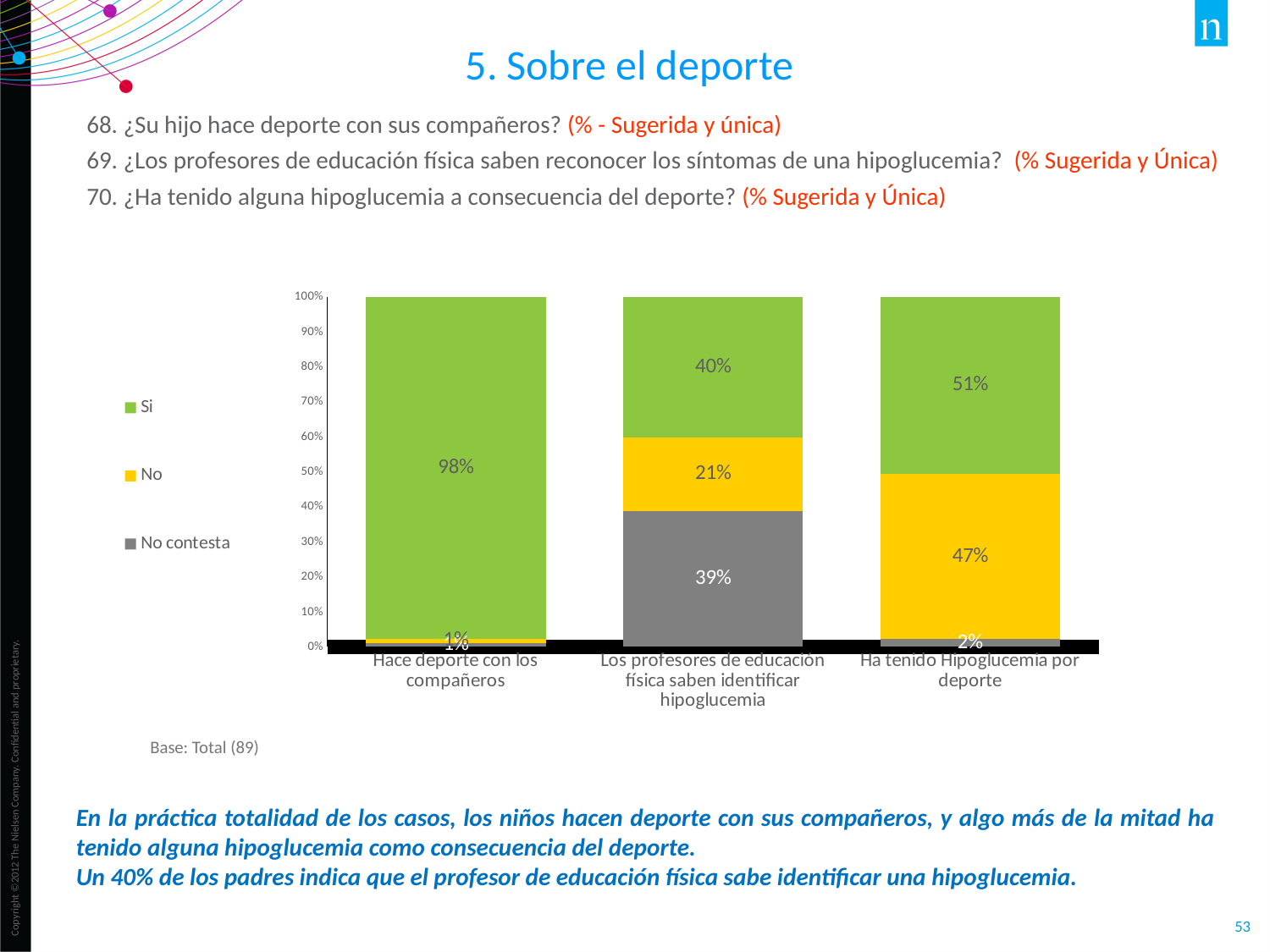
Which category has the highest 'Si' value? Hace deporte con los compañeros What is the value of 'No contesta' for 'Los profesores de educación física saben identificar hipoglucemia'? 39% How many series does the legend list? 3 Which colour represents the 'No' series in the chart? yellow What is the value of 'Si' for 'Los profesores de educación física saben identificar hipoglucemia'? 40% What is the value of 'Si' for 'Ha tenido Hipoglucemia por deporte'? 51% What is the difference between the 'Si' and 'No' values for 'Los profesores de educación física saben identificar hipoglucemia'? 19% What is the value of 'No' for 'Ha tenido Hipoglucemia por deporte'? 47% Which is larger for 'Ha tenido Hipoglucemia por deporte': the 'Si' value or the 'No' value? Si How many categories are shown on the x axis of the chart? 3 What is the value of 'Si' for 'Hace deporte con los compañeros'? 98% What kind of chart is shown on the slide? stacked bar chart